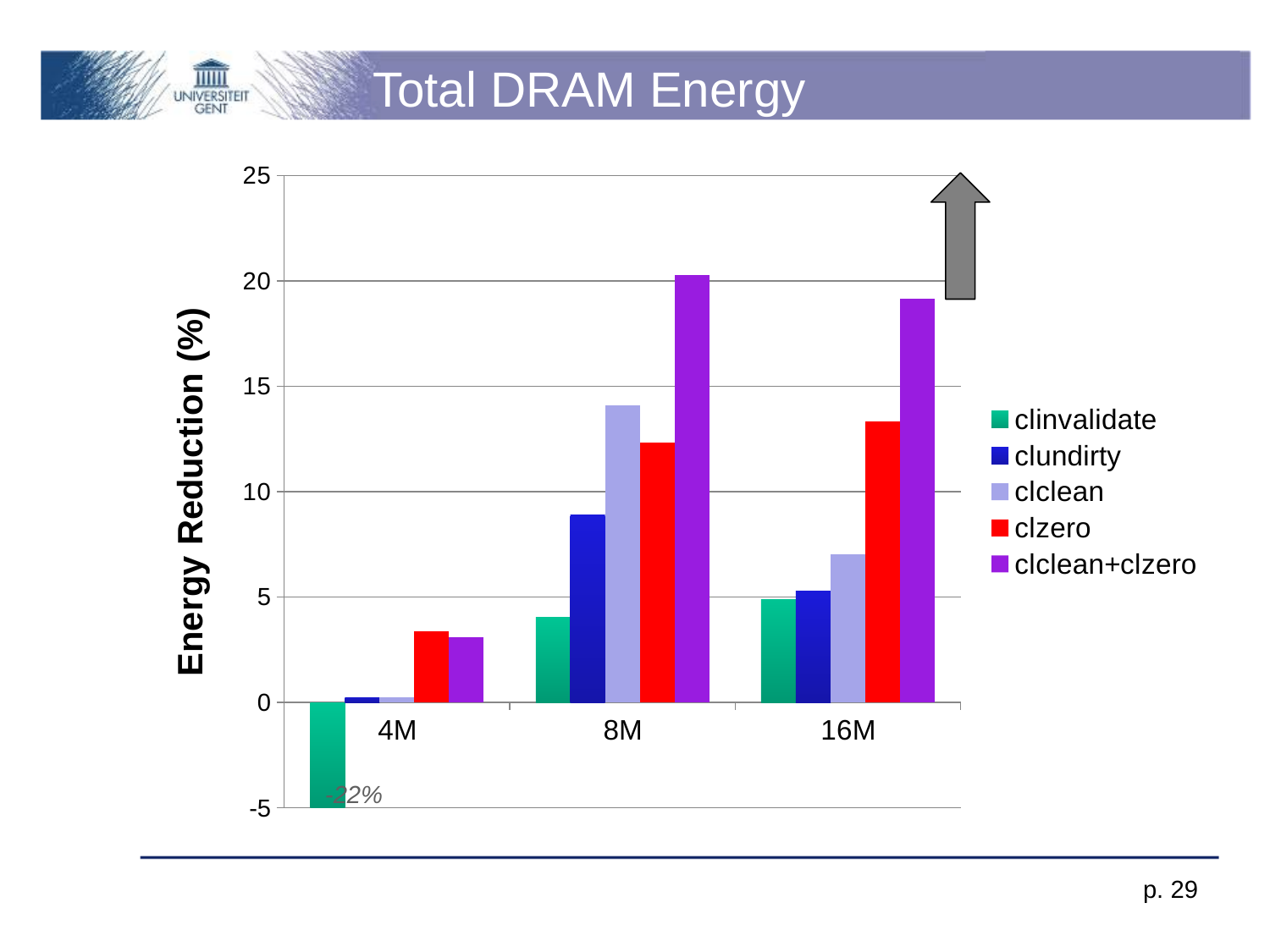
What kind of chart is shown on the slide? bar chart What is the title of the chart? Total DRAM Energy How many series does the legend list? 5 What is the y-axis title of the chart? Energy Reduction (%) At 8M, which is larger: clclean or clzero? clclean Which series has the lowest value for 4M? clinvalidate Is the value for clinvalidate at 8M greater or less than 5? less For which category is the clclean+clzero value highest? 8M Is the value for clzero at 16M greater or less than 10? greater Is the value for clclean+clzero at 8M greater or less than 15? greater How many categories are shown on the x axis? 3 What value is annotated on the clinvalidate bar for 4M? -22%